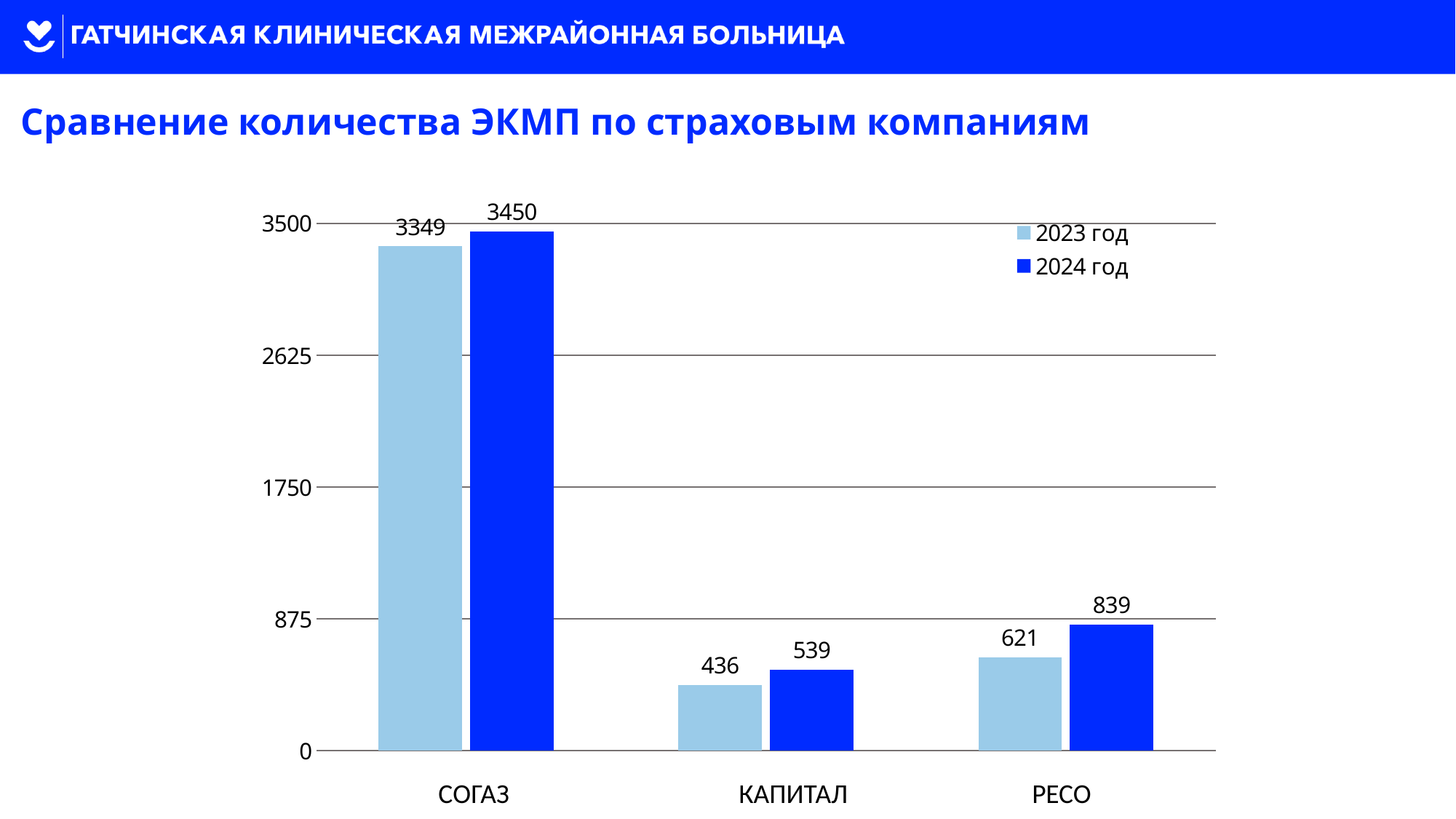
Which is larger: the 2023 год value for РЕСО or the 2024 год value for КАПИТАЛ? 2023 год value for РЕСО Which company has the highest value in 2024 год? СОГАЗ Is the 2024 год value for РЕСО greater or less than 875? less What is the difference between the 2024 год and 2023 год values for РЕСО? 218 What is the value for КАПИТАЛ in 2024 год? 539 How many companies are shown on the x axis? 3 Which company has the lowest value in 2023 год? КАПИТАЛ What is the difference between the 2024 год and 2023 год values for СОГАЗ? 101 What is the value for СОГАЗ in 2023 год? 3349 What is the value for РЕСО in 2023 год? 621 What kind of chart is shown on the slide? bar chart How many series does the legend list? 2